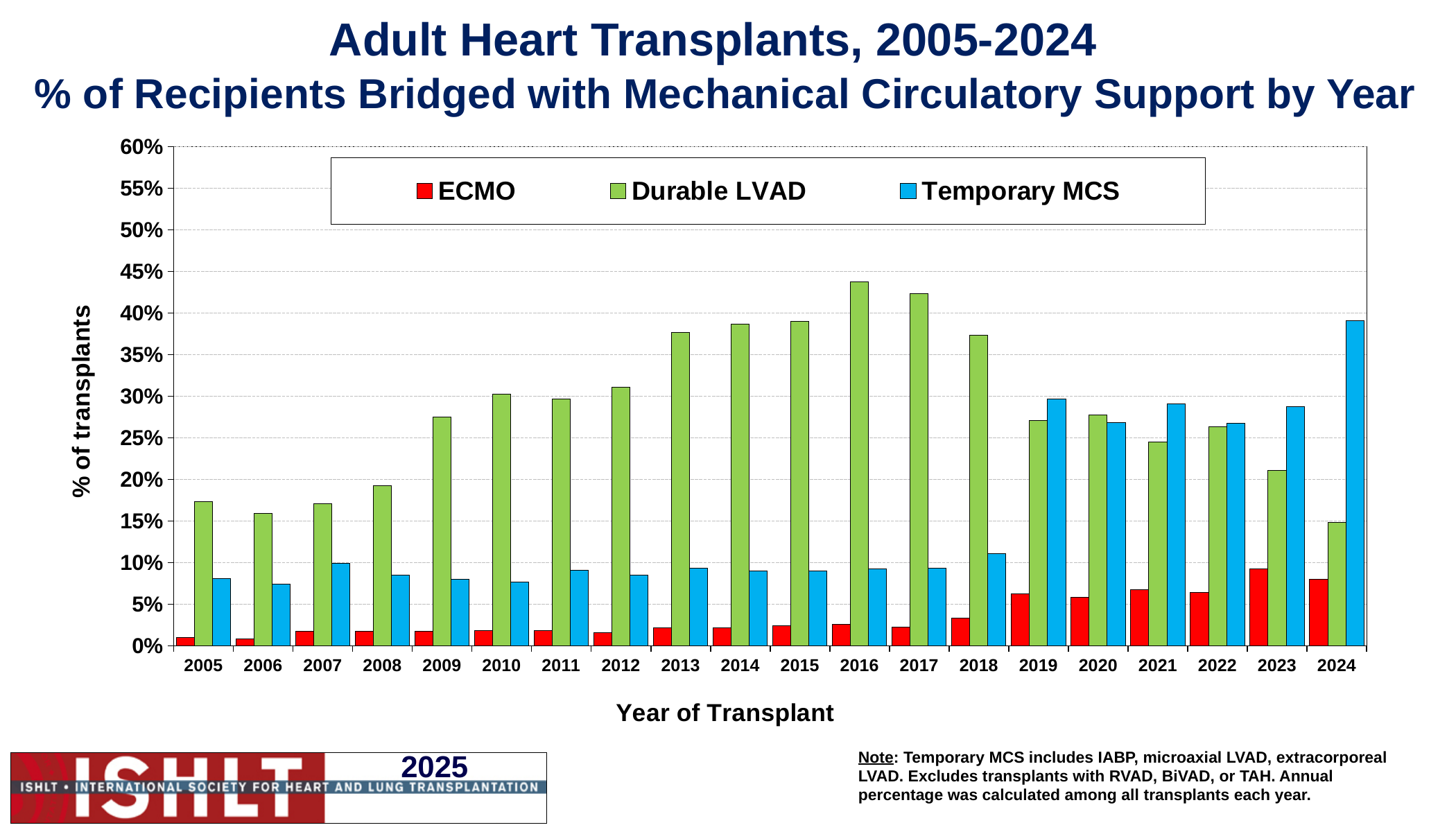
In which year is the ECMO value highest? 2023 Is the ECMO value for 2023 greater or less than 10%? less Is the Durable LVAD value for 2016 greater or less than 40%? greater In which year is the Durable LVAD value highest? 2016 How many series does the legend list? 3 Does the Durable LVAD value rise or fall from 2016 to 2024? fall In which year is the Temporary MCS value highest? 2024 Is the Temporary MCS value for 2024 greater or less than 35%? greater In 2016, which is larger: Durable LVAD or Temporary MCS? Durable LVAD How many years are shown on the x axis? 20 What kind of chart is shown on the slide? bar chart In 2024, which is larger: Durable LVAD or Temporary MCS? Temporary MCS